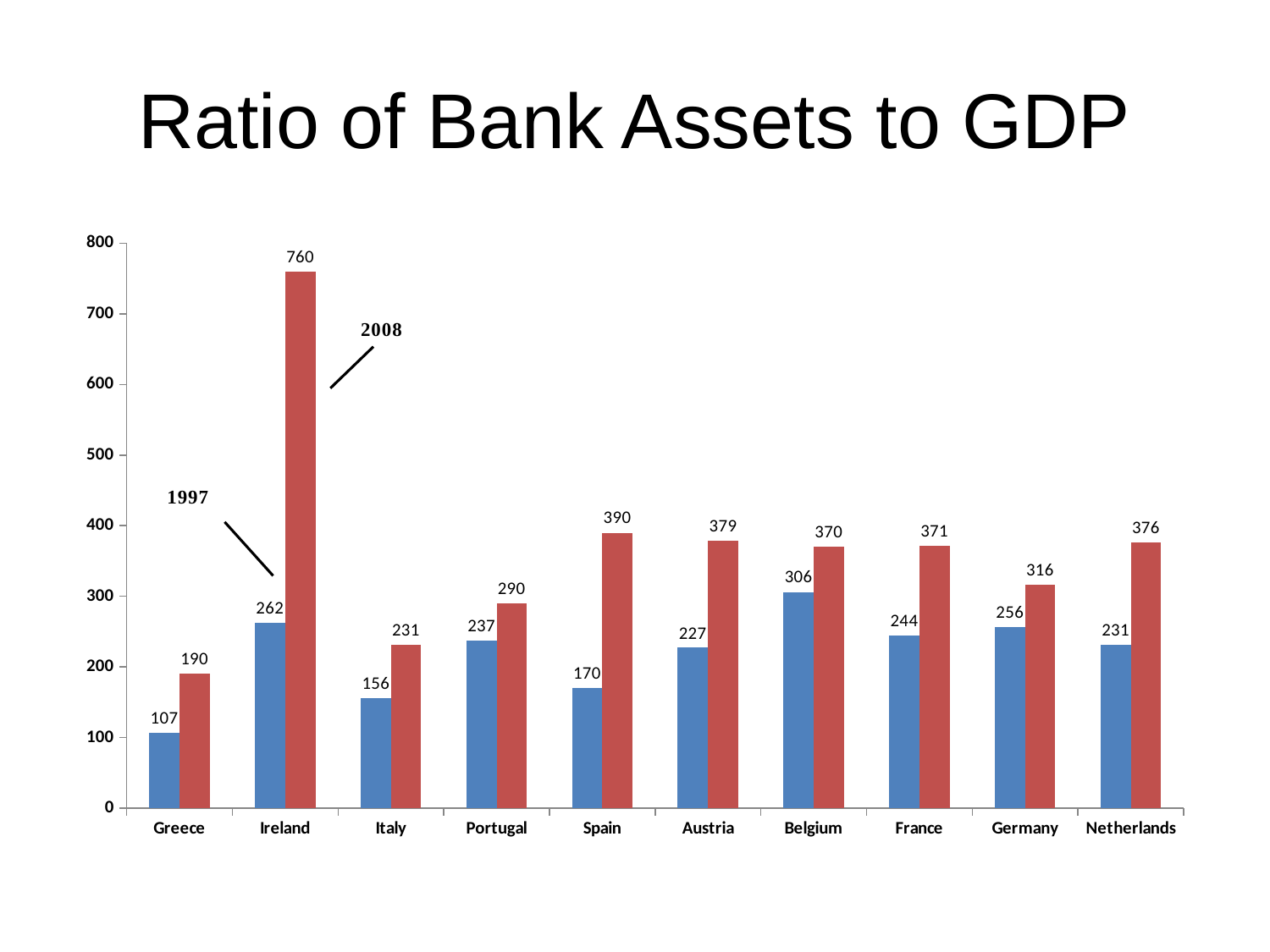
Which country has the highest 2008 ratio of bank assets to GDP? Ireland What is the title of the slide? Ratio of Bank Assets to GDP Which country has the lowest 1997 ratio of bank assets to GDP? Greece How many countries are shown on the x axis? 10 How many series (years) does the chart show? 2 What is the 1997 ratio of bank assets to GDP for Greece? 107 What is the difference between Ireland's 2008 and 1997 values? 498 Is the 2008 value for Portugal greater or less than 300? less What is the 2008 value for Spain? 390 What kind of chart is shown on the slide? Bar chart Which is larger: Belgium's 1997 value or Germany's 1997 value? Belgium's 1997 value What is the 2008 ratio of bank assets to GDP for Ireland? 760